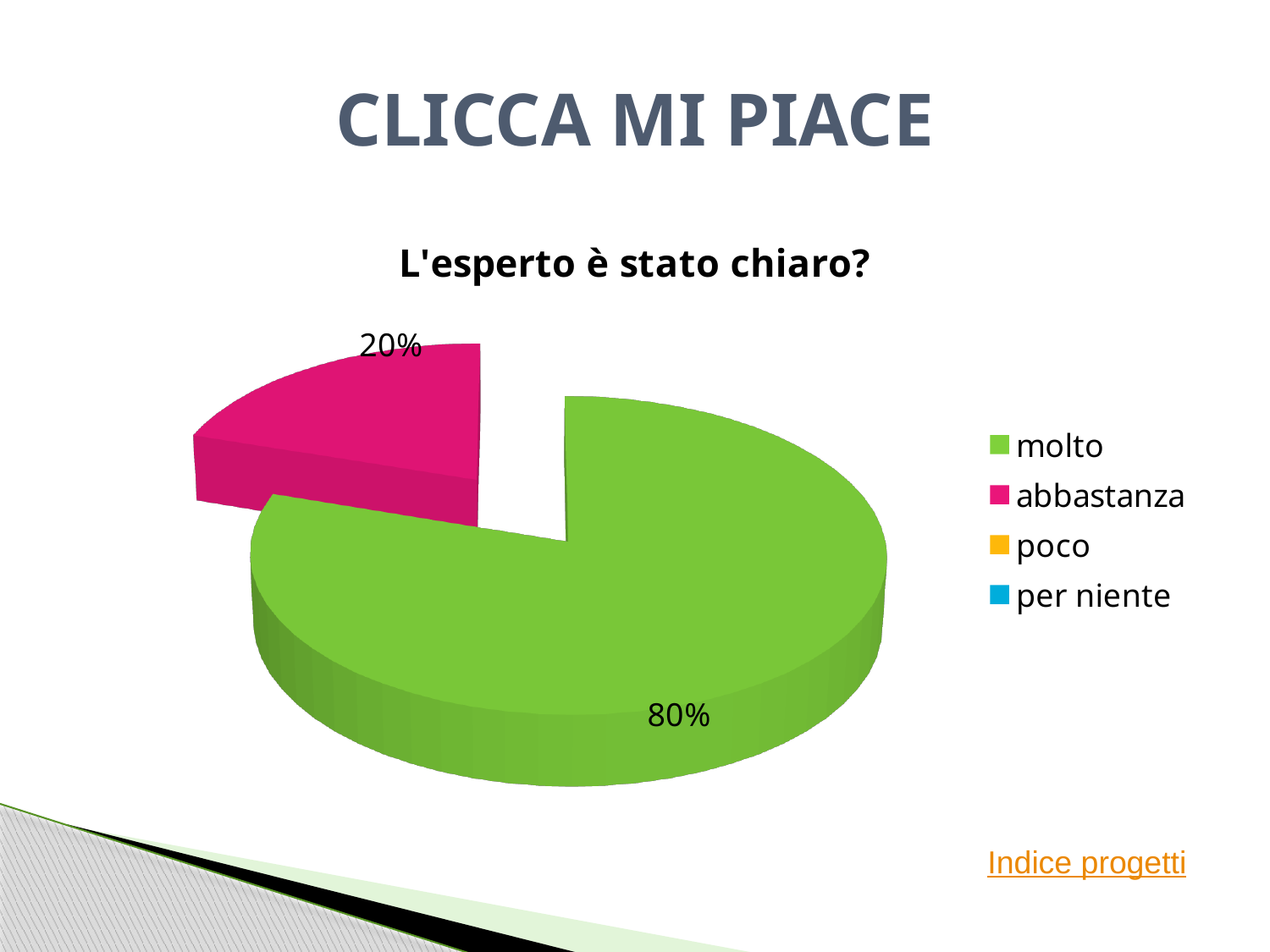
What is the title of the chart? L'esperto è stato chiaro? How many entries does the legend list? 4 What kind of chart is shown on the slide? pie chart What percentage of the pie is labelled for "molto"? 80% What percentage of the pie is labelled for "abbastanza"? 20% What colour is the slice for "abbastanza"? pink How many slices are visible in the pie? 2 What is the combined share of "molto" and "abbastanza"? 100% What is the difference between the shares for "molto" and "abbastanza"? 60% Which category has the largest share of the pie? molto Which is larger, the share for "molto" or the share for "abbastanza"? molto